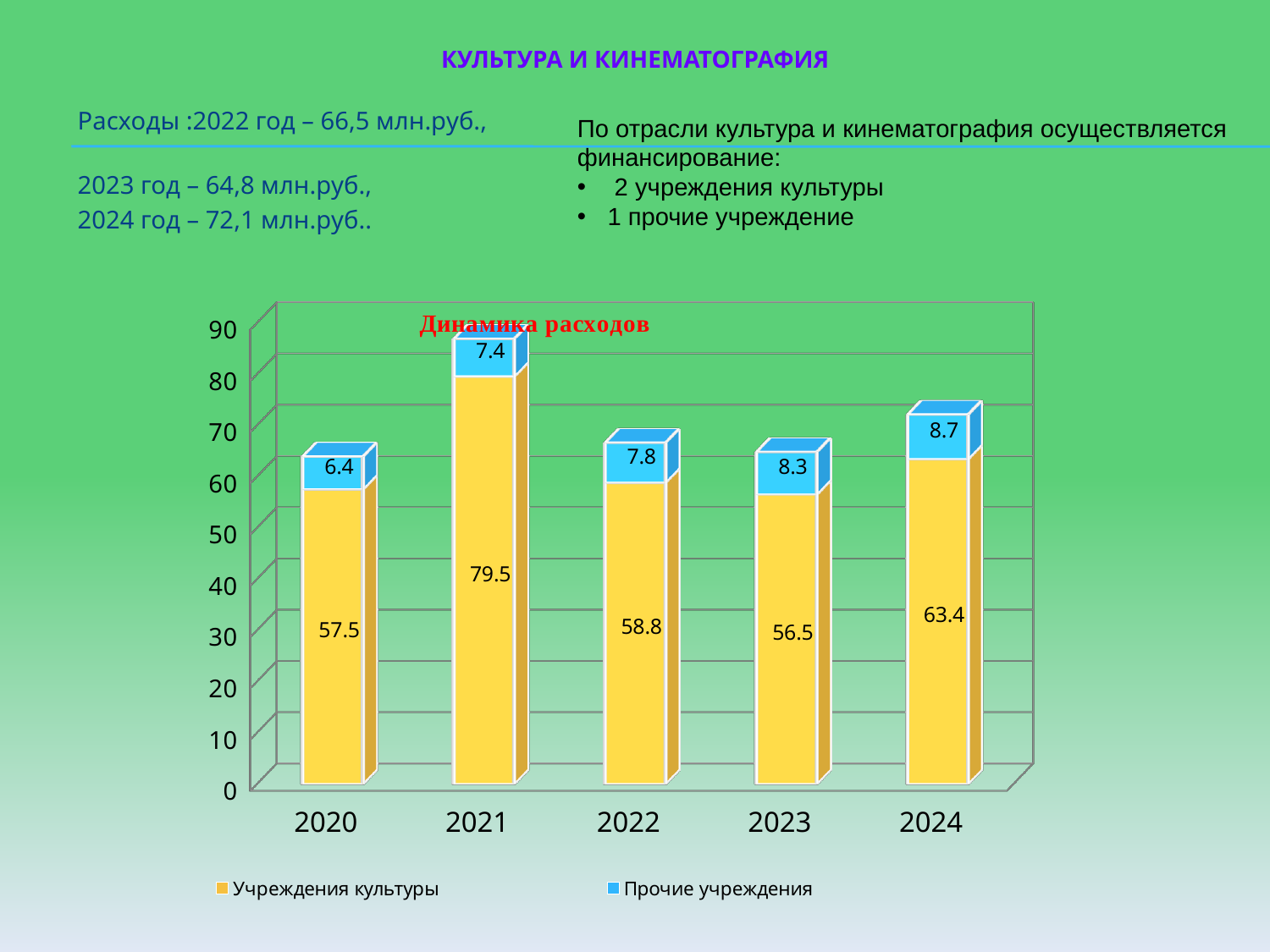
What is the total of the stacked bar for 2024? 72.1 Which is larger, the Учреждения культуры value for 2022 or for 2024? 2024 What is the difference between the Учреждения культуры values for 2021 and 2020? 22 Which year has the highest value for Учреждения культуры? 2021 What is the value for Учреждения культуры in 2023? 56.5 What is the total of the stacked bar for 2023? 64.8 What is the value for Учреждения культуры in 2021? 79.5 Which year has the lowest value for Прочие учреждения? 2020 What kind of chart is shown on the slide? Stacked bar chart How many years are shown on the x axis? 5 What is the value for Прочие учреждения in 2024? 8.7 How many series does the legend list? 2